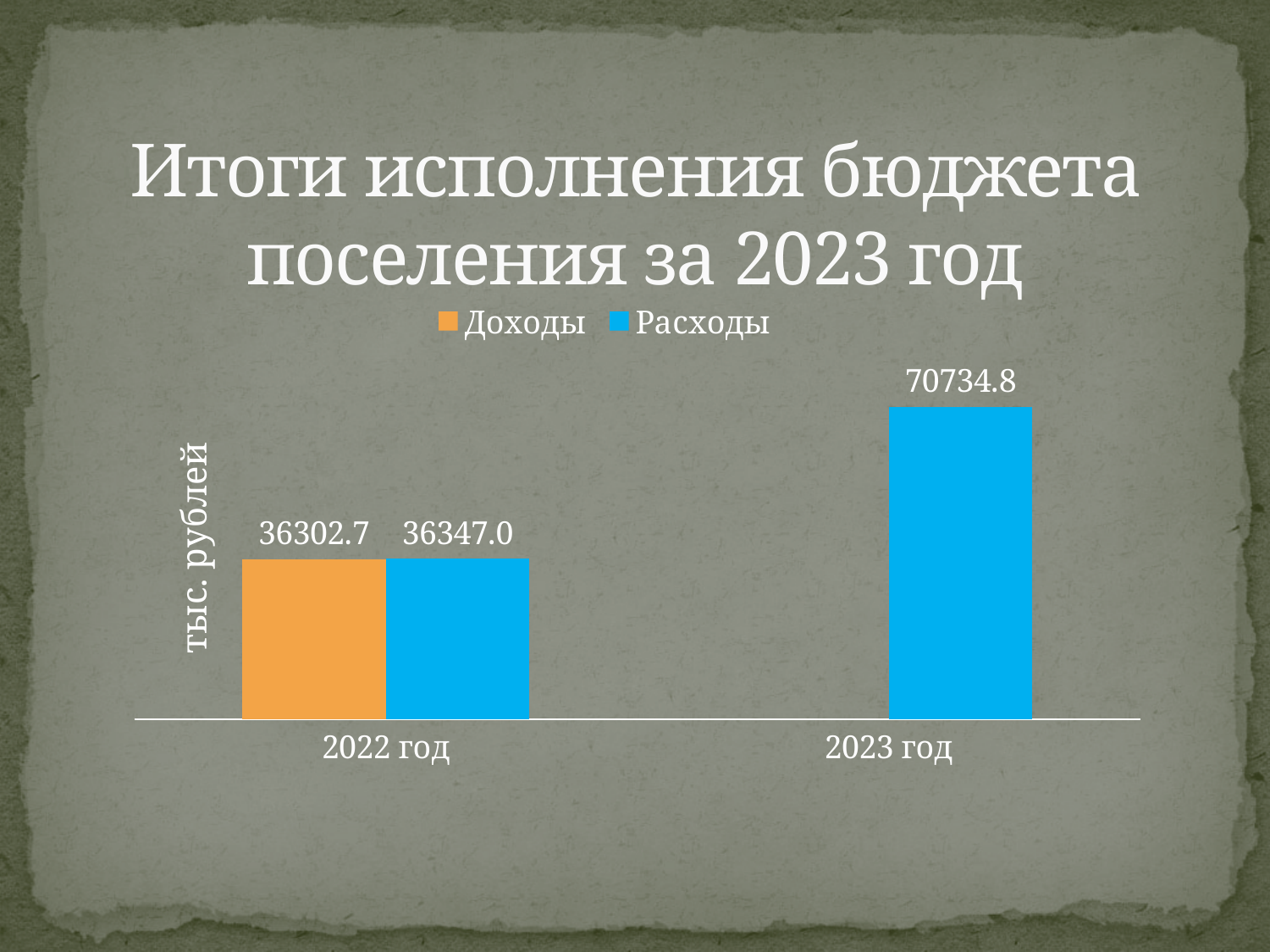
How many year categories are shown on the x axis? 2 How many series does the legend list? 2 What is the difference between Расходы for 2023 год and Расходы for 2022 год? 34387.8 Which is larger: Расходы for 2023 год or Расходы for 2022 год? Расходы for 2023 год Do the Расходы values rise or fall from 2022 год to 2023 год? Rise What is the value of Доходы for 2022 год? 36302.7 Which bar has the lowest value on the chart? Доходы, 2022 год Which bar has the highest value on the chart? Расходы, 2023 год What is the value of Расходы for 2022 год? 36347.0 What kind of chart is shown on the slide? Bar chart What is the value of Расходы for 2023 год? 70734.8 What is the difference between Расходы and Доходы for 2022 год? 44.3